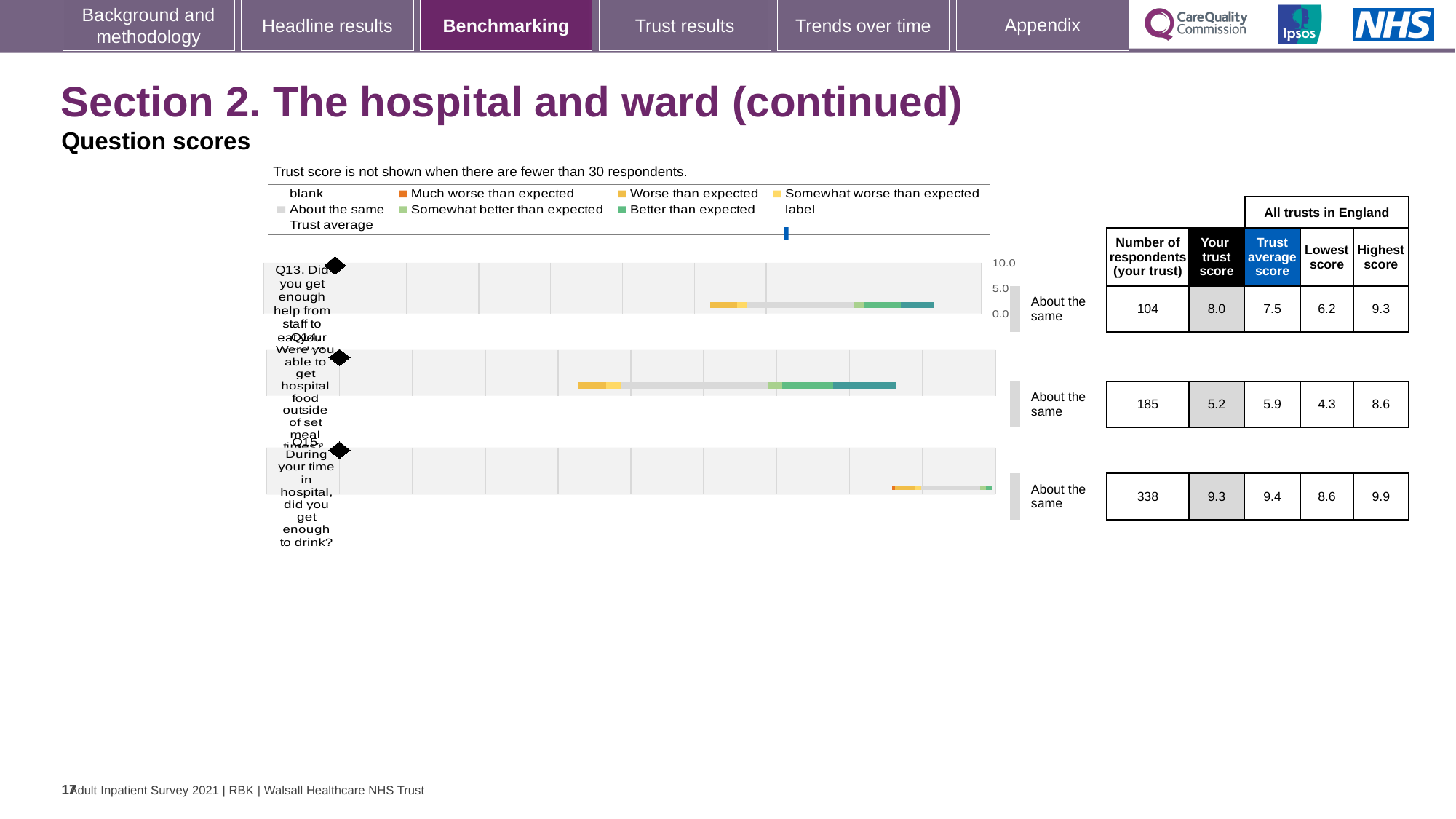
Which of the three questions shown has the lowest trust score? Q14 What is the trust score for Q13 (Did you get enough help from staff to eat your meals)? 8.0 What is the trust average score across all trusts in England for Q14? 5.9 Is the trust score for Q14 higher or lower than the trust average score for Q14? lower How many questions are plotted on the chart? 3 Which of the three questions shown has the highest trust score? Q15 What is the difference between the trust score and the trust average score for Q13? 0.5 What is the trust score for Q14 (Were you able to get hospital food outside of set meal times)? 5.2 What is the trust score for Q15 (During your time in hospital, did you get enough to drink)? 9.3 Is the trust score for Q13 greater or less than 5.0 on the chart axis? greater What kind of chart is used to show the question scores? bar chart How many respondents answered Q15 at this trust? 338